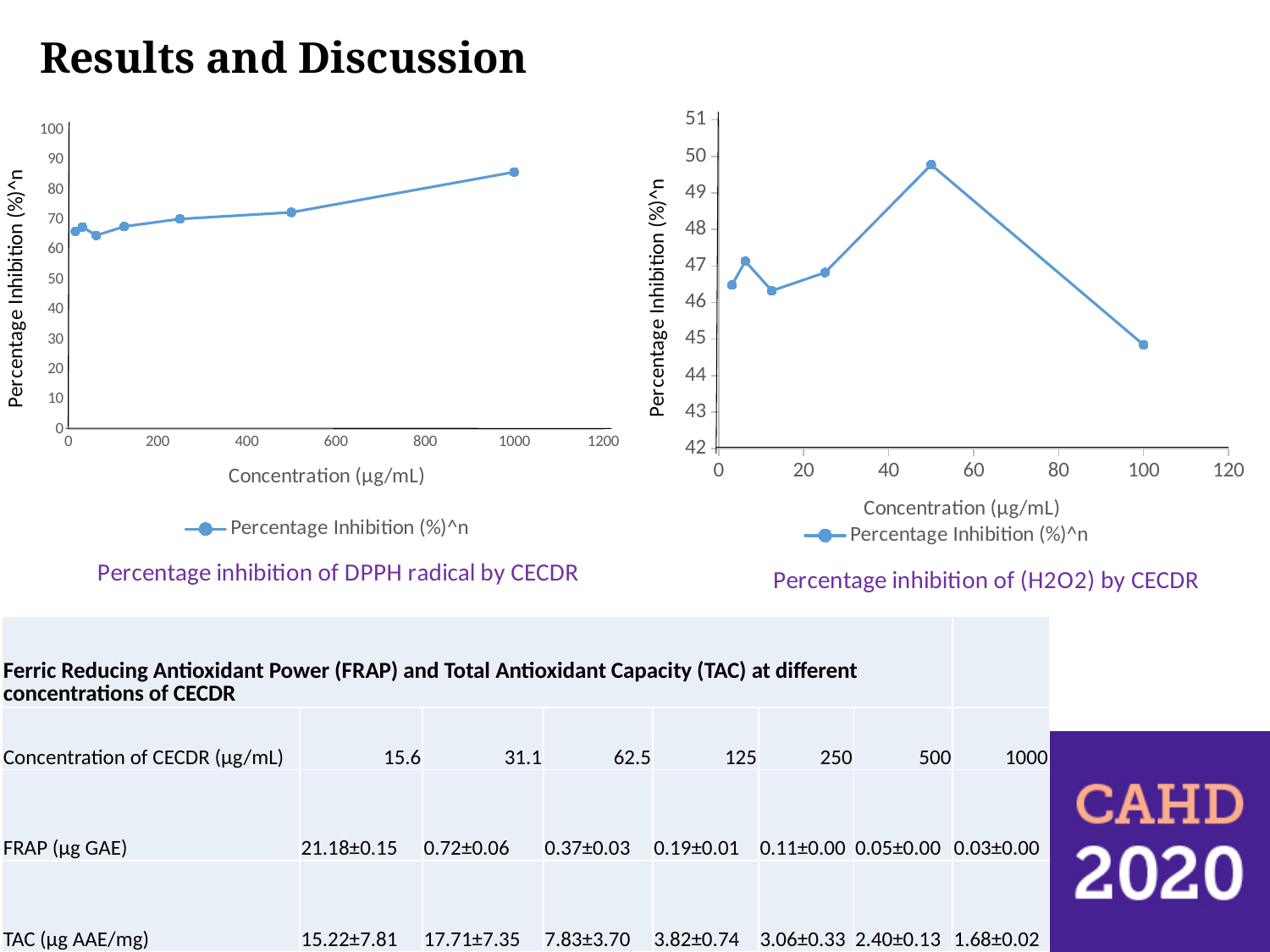
In the right chart (H2O2), is the percentage inhibition at a concentration of 50 µg/mL greater or less than 49? greater In the right chart (H2O2), at which concentration is the percentage inhibition lowest? 100 µg/mL What is the x-axis label of the left chart (DPPH radical)? Concentration (µg/mL) In the left chart (DPPH radical), is the percentage inhibition at a concentration of 1000 µg/mL greater or less than 80? greater In the left chart (DPPH radical), how many series does the legend list? 1 In the right chart (H2O2), at which concentration is the percentage inhibition highest? 50 µg/mL How many data points are plotted in the right chart (H2O2)? 6 In the left chart (DPPH radical), does the percentage inhibition generally rise or fall as concentration increases? rise What kind of chart is the right chart, 'Percentage inhibition of (H2O2) by CECDR'? line chart In the left chart (DPPH radical), at which concentration is the percentage inhibition highest? 1000 µg/mL In the right chart (H2O2), is the percentage inhibition at a concentration of 100 µg/mL greater or less than 46? less What kind of chart is the left chart, 'Percentage inhibition of DPPH radical by CECDR'? line chart